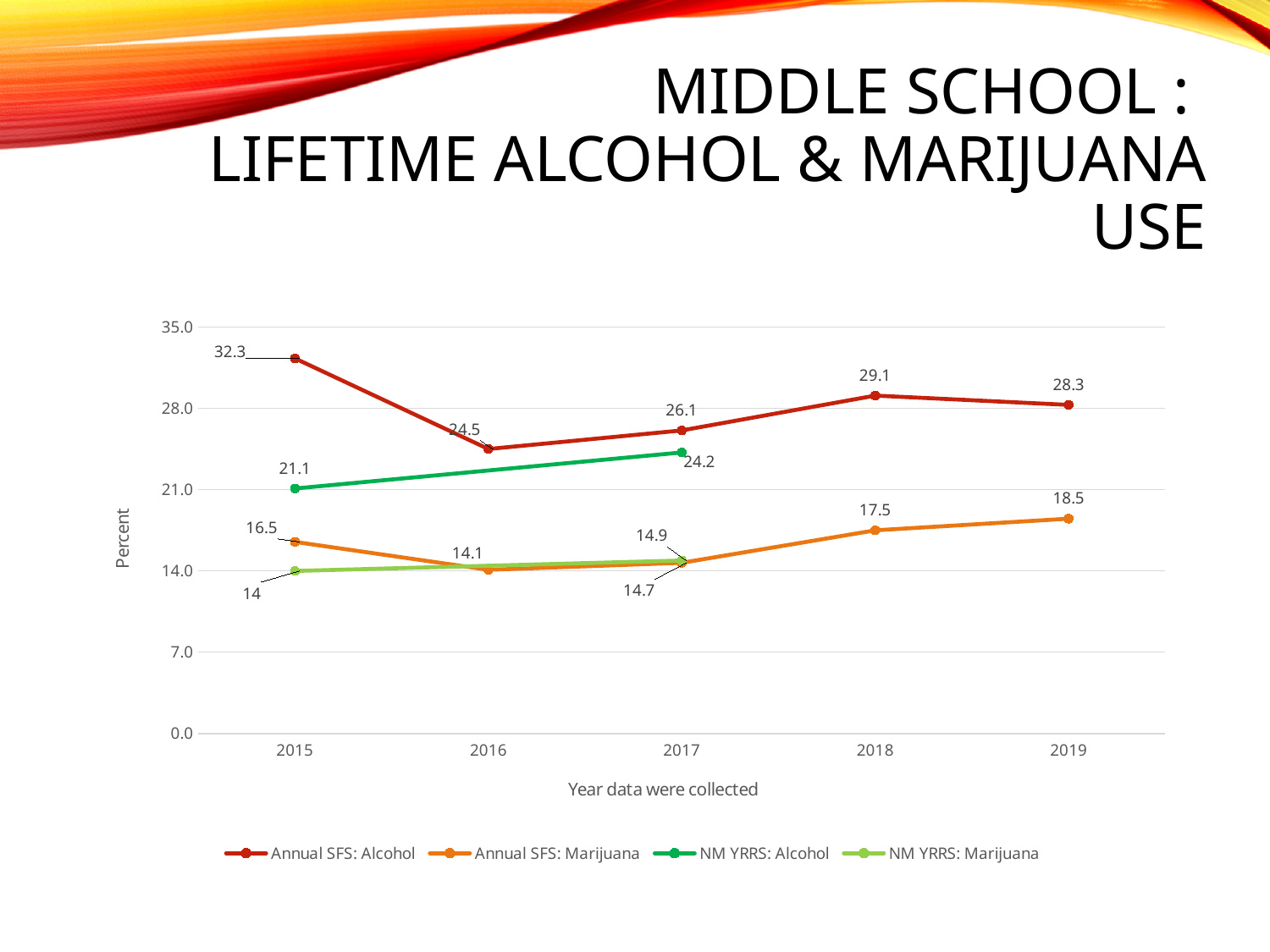
What is the difference between the NM YRRS: Alcohol values for 2017 and 2015? 3.1 What is the difference between the Annual SFS: Alcohol values for 2015 and 2016? 7.8 What is the value for NM YRRS: Alcohol in 2017? 24.2 Which year has the larger Annual SFS: Alcohol value, 2018 or 2019? 2018 What is the value for NM YRRS: Marijuana in 2015? 14 In which year is the Annual SFS: Alcohol value lowest? 2016 What is the value for Annual SFS: Alcohol in 2019? 28.3 How many series does the legend list? 4 What kind of chart is shown on the slide? Line chart What is the value for Annual SFS: Alcohol in 2015? 32.3 What is the value for Annual SFS: Marijuana in 2018? 17.5 In which year is the Annual SFS: Alcohol value highest? 2015